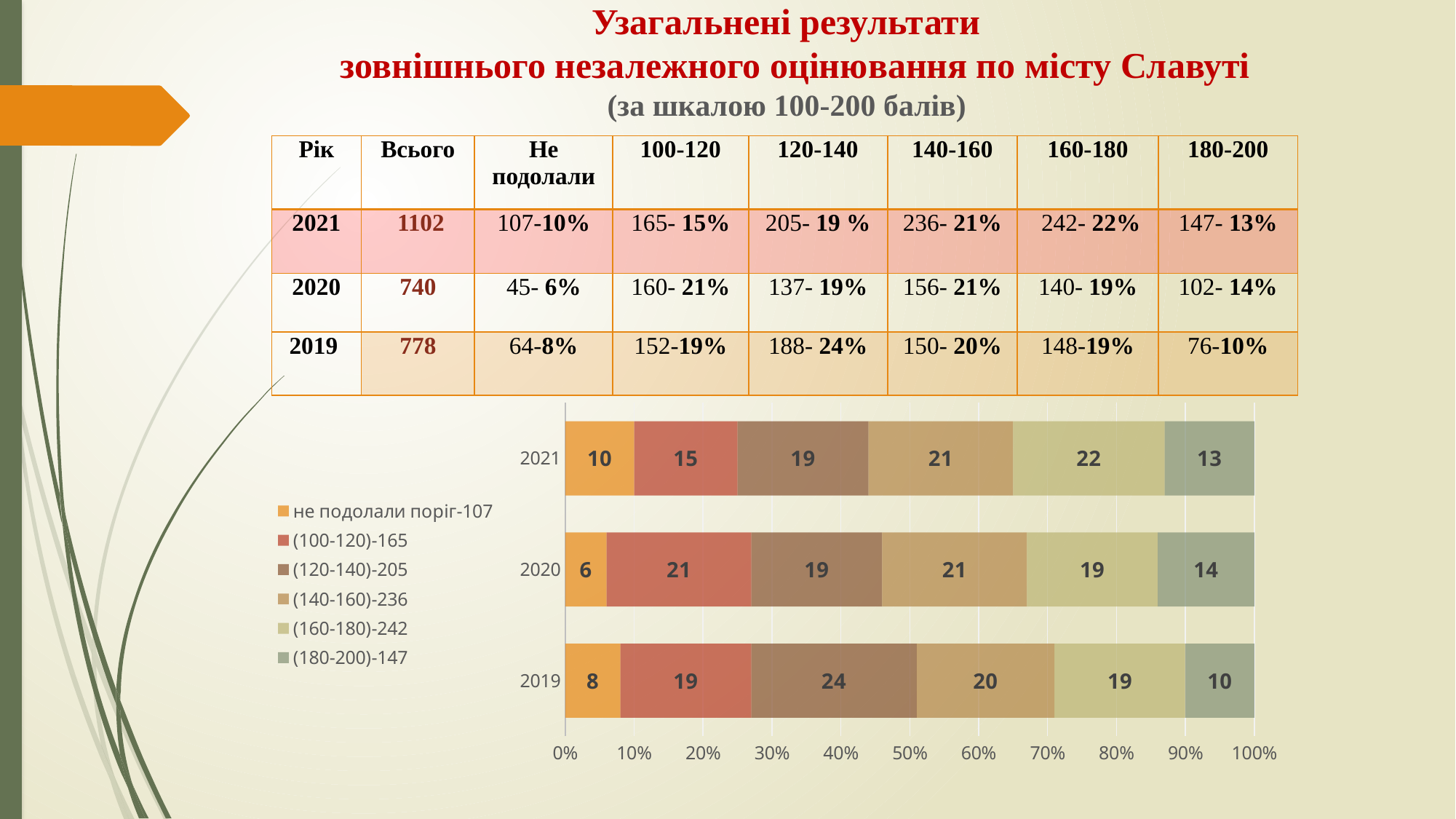
What is the value of the "(180-200)-147" segment for 2020? 14 What kind of chart is shown on the slide? stacked bar chart What is the first legend entry of the chart? не подолали поріг-107 Which year has the lowest value for the "не подолали поріг-107" series? 2020 Which segment is the largest in the 2019 bar? (120-140)-205 How many years (categories) does the chart show? 3 How many series does the chart legend list? 6 What is the value of the "(120-140)-205" segment for 2019? 24 What is the difference between the "(100-120)-165" values for 2020 and 2021? 6 Which year has the highest value for the "(160-180)-242" series? 2021 What is the value of the "не подолали поріг-107" segment for 2021? 10 Which is larger: the "(180-200)-147" value for 2021 or for 2019? 2021